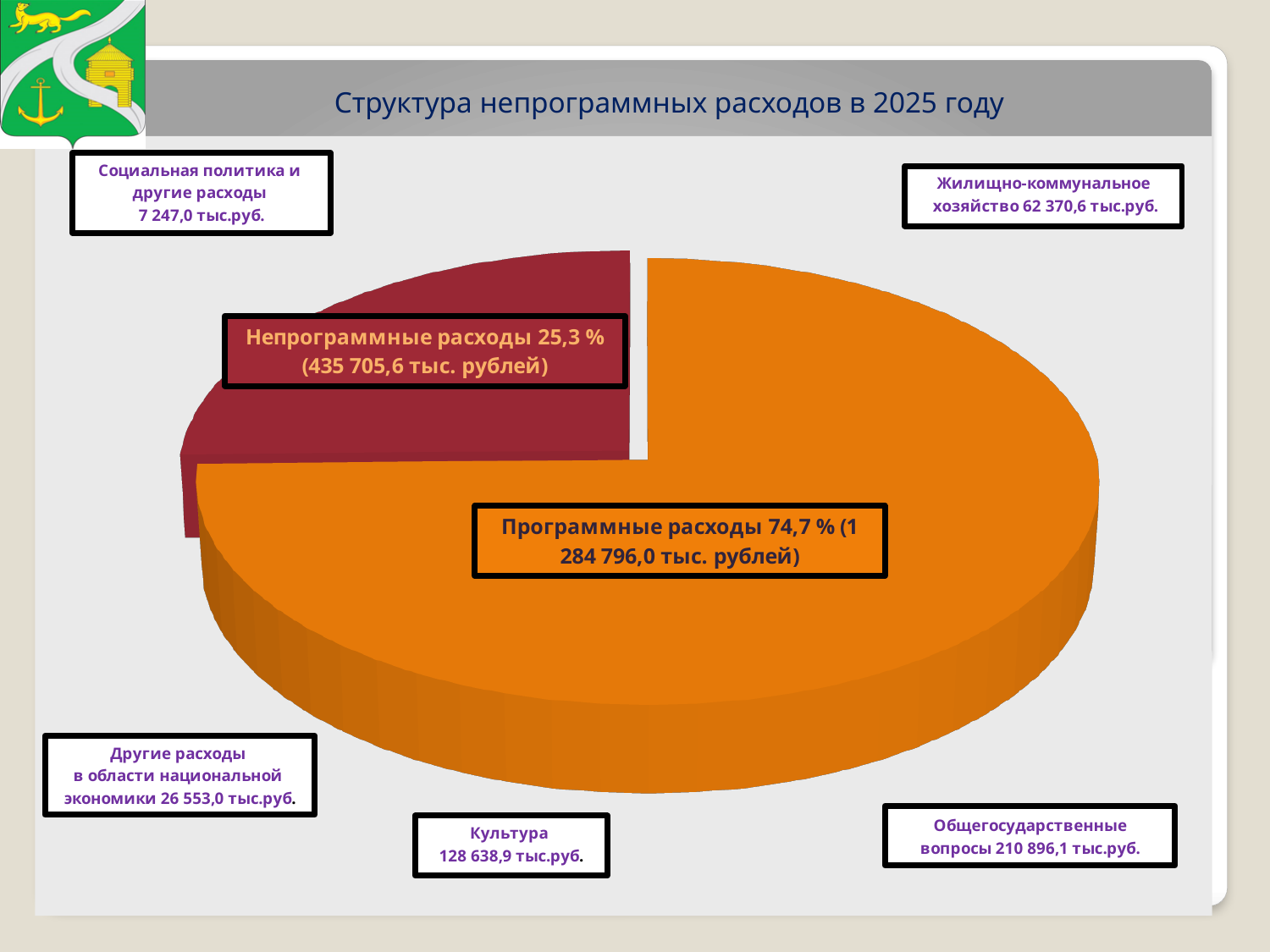
What share of the pie is Непрограммные расходы? 25,3 % What is the value in тыс. рублей for Непрограммные расходы? 435 705,6 тыс. рублей Which slice of the pie is the smallest? Непрограммные расходы What share of the pie is Программные расходы? 74,7 % How many slices does the pie chart have? 2 What is the title of the chart on the slide? Структура непрограммных расходов в 2025 году Which is larger, the share for Программные расходы or the share for Непрограммные расходы? Программные расходы What kind of chart is shown on the slide? Pie chart Which slice of the pie is the largest? Программные расходы By how many percentage points does the share of Программные расходы exceed the share of Непрограммные расходы? 49,4 What colour is the slice for Непрограммные расходы? Dark red What is the value in тыс. рублей for Программные расходы? 1 284 796,0 тыс. рублей